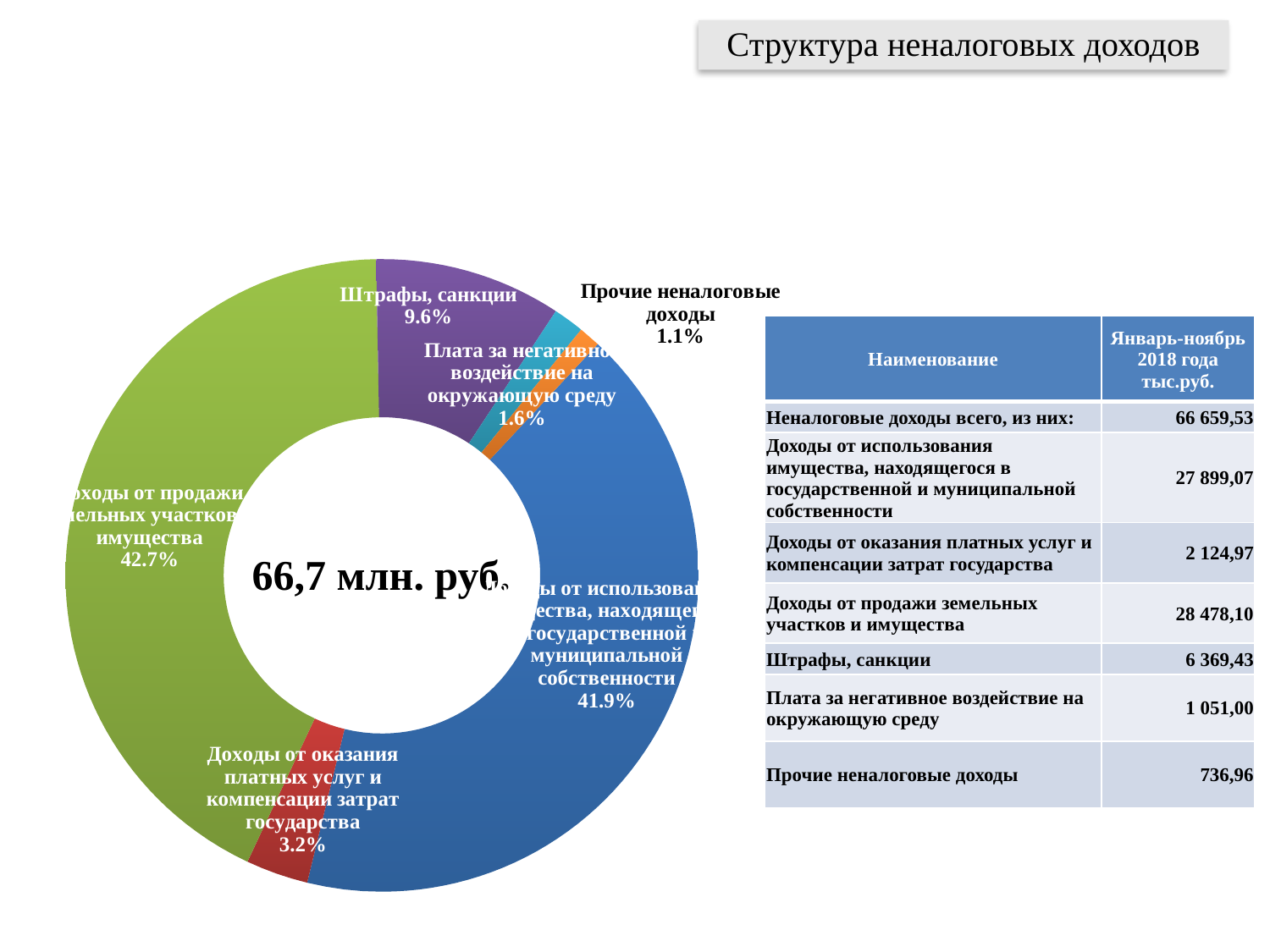
Which is larger in the chart: the share of "Штрафы, санкции" or the share of "Плата за негативное воздействие на окружающую среду"? Штрафы, санкции Which category has the smallest share in the chart? Прочие неналоговые доходы (1.1%) By how many percentage points does the share of "Доходы от продажи земельных участков и имущества" exceed the share of "Доходы от использования имущества" in the chart? 0.8 percentage points Which category has the largest share in the chart? Доходы от продажи земельных участков и имущества (42.7%) What kind of chart is shown on the slide? Doughnut (pie) chart What share does "Доходы от оказания платных услуг и компенсации затрат государства" have in the chart? 3.2% What share does "Плата за негативное воздействие на окружающую среду" have in the chart? 1.6% What share does "Прочие неналоговые доходы" have in the chart? 1.1% How many categories (slices) does the chart show? 6 What total value is printed in the centre of the doughnut chart? 66,7 млн. руб. What share does "Доходы от использования имущества, находящегося в государственной и муниципальной собственности" have in the chart? 41.9% What share of non-tax revenues does "Штрафы, санкции" account for in the chart? 9.6%